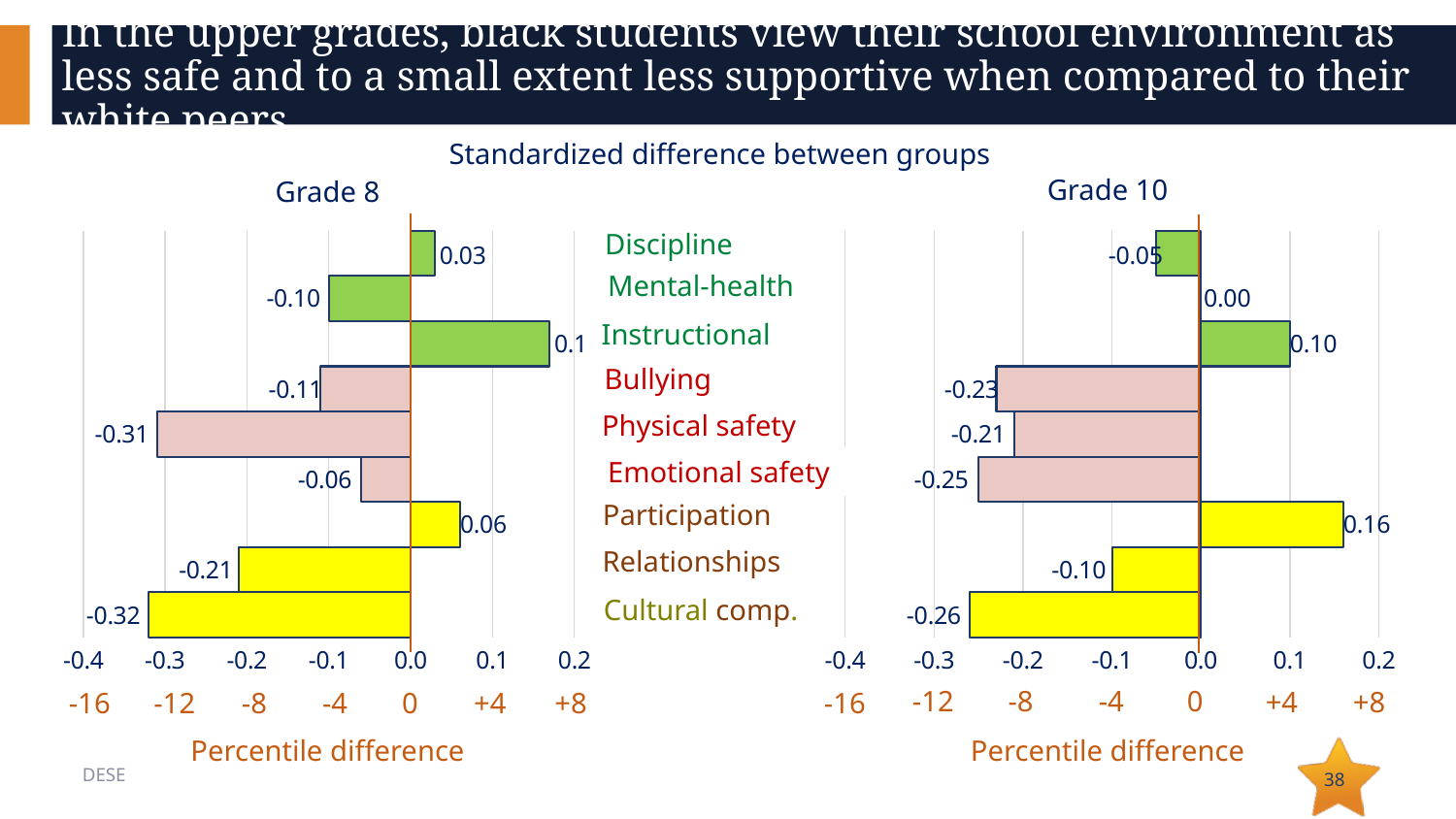
In the Grade 8 chart, what is the difference between the values for Relationships and Cultural comp.? 0.11 In the Grade 10 chart, what is the value for Participation? 0.16 In the Grade 10 chart, what is the difference between the values for Bullying and Physical safety? 0.02 In the Grade 10 chart, which category has the highest value? Participation In the Grade 10 chart, what is the value for Emotional safety? -0.25 What kind of chart is the Grade 10 chart? Bar chart In the Grade 8 chart, what is the value for Cultural comp.? -0.32 In the Grade 8 chart, what is the value for Physical safety? -0.31 How many categories are shown in the Grade 8 chart? 9 In the Grade 10 chart, which is larger, the value for Participation or the value for Instructional? Participation In the Grade 10 chart, what is the value for Mental-health? 0.00 In the Grade 8 chart, which category has the highest value? Instructional